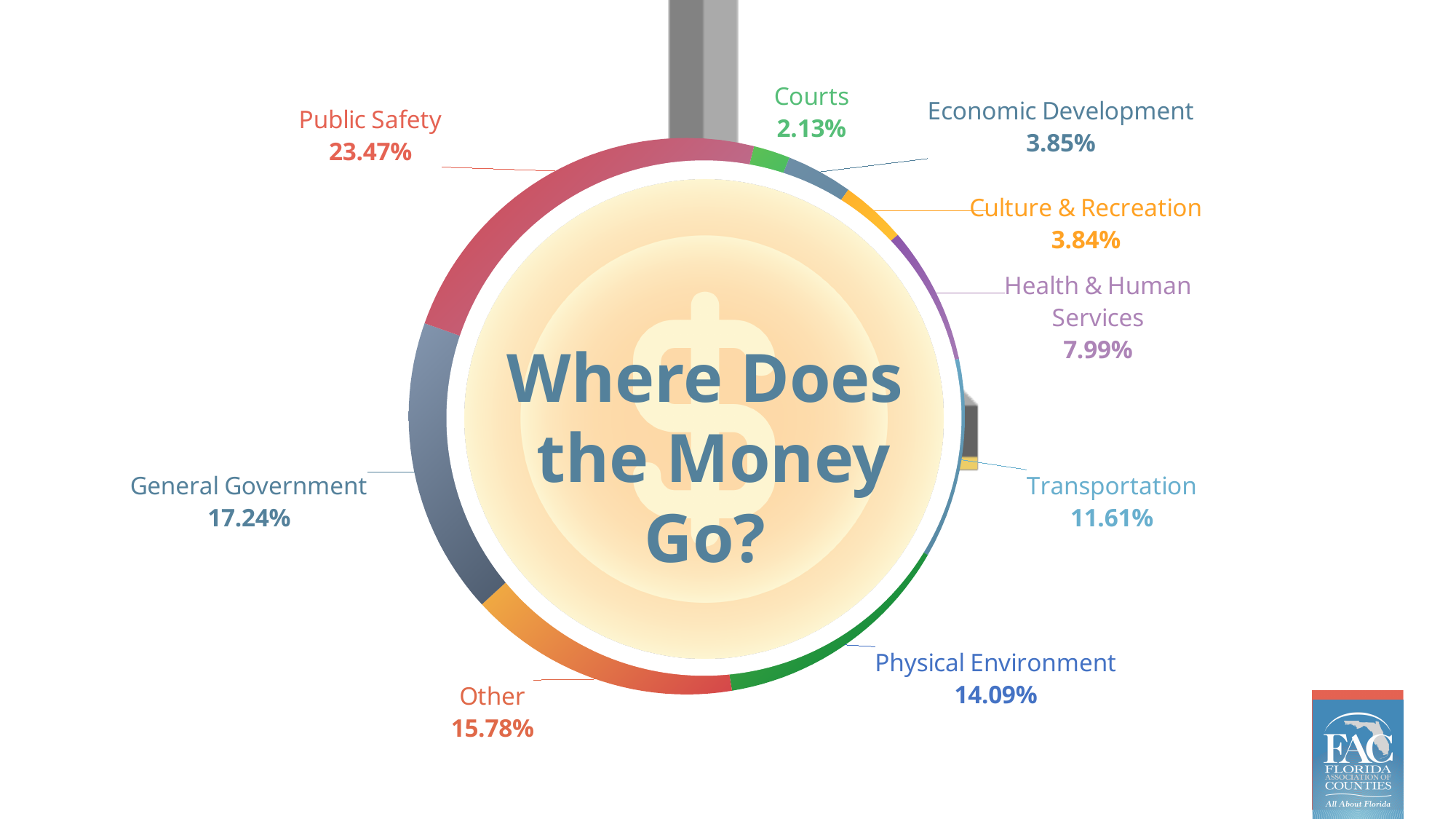
What is the title shown in the centre of the chart? Where Does the Money Go? Which category receives the largest share of the money? Public Safety Which category receives the smallest share of the money? Courts What percentage of the money goes to Public Safety? 23.47% What percentage is shown for Physical Environment? 14.09% How many percentage points larger is Public Safety's share than General Government's share? 6.23 What kind of chart is shown on the slide? Pie (donut) chart How many categories are shown in the chart? 9 What is the value shown for Health & Human Services? 7.99% What share does Transportation receive? 11.61% What is the difference between the Transportation share and the Health & Human Services share? 3.62% Which is larger, the share for Other or the share for Physical Environment? Other